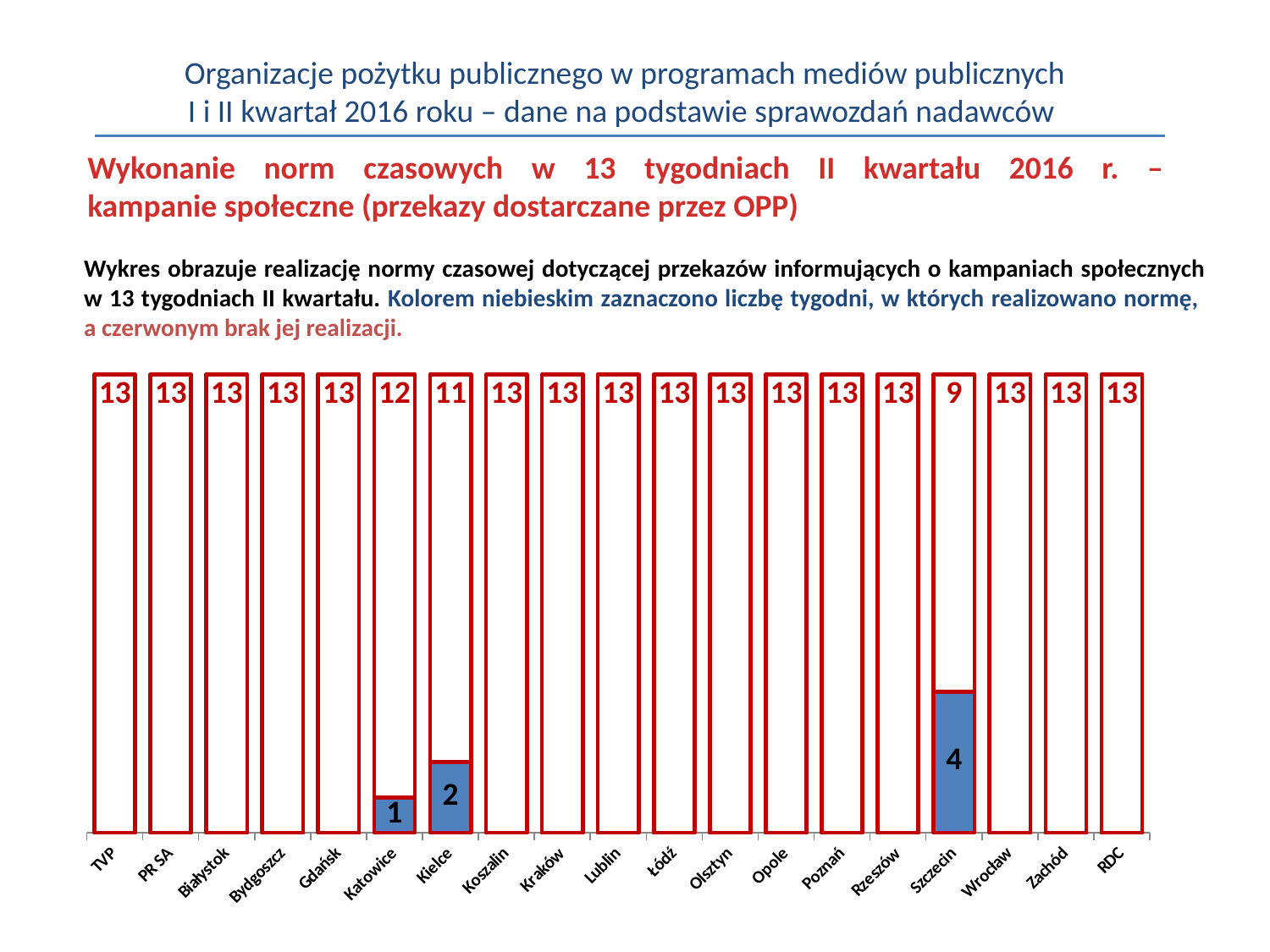
What is the total of the stacked bar for Szczecin (red plus blue)? 13 What is the blue (norm realized) value for Katowice? 1 What is the red value for Kielce? 11 How many categories (broadcasters) are shown on the x axis of the chart? 19 What is the blue (norm realized) value for Kielce? 2 According to the slide text, what does the blue colour in the chart represent? the number of weeks in which the norm was realized Which is larger, the blue value for Kielce or the blue value for Katowice? Kielce Which broadcaster has the lowest red (norm not realized) value? Szczecin Which broadcaster has the highest blue (norm realized) value? Szczecin What is the red (norm not realized) value for Szczecin? 9 What is the difference between the red value for Katowice and the red value for Szczecin? 3 What kind of chart is shown on the slide? bar chart